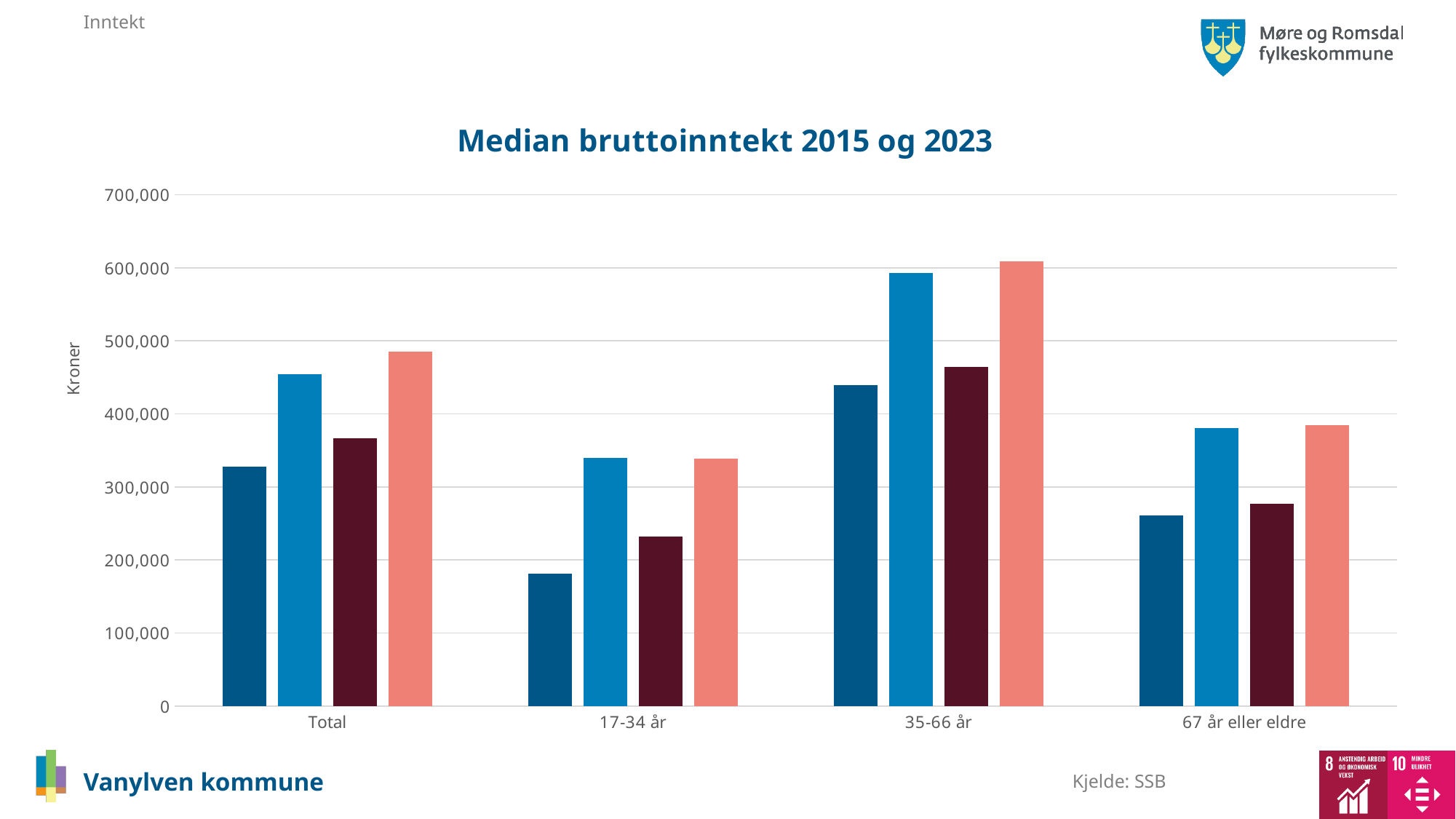
Is the value of the dark red (third) bar for 67 år eller eldre greater or less than 300,000? less What is the title of the chart? Median bruttoinntekt 2015 og 2023 Which is larger: the dark red (third) bar for Total or the dark red (third) bar for 35-66 år? 35-66 år Is the value of the dark blue (first) bar for Total greater or less than 300,000? greater Is the value of the light blue (second) bar for 35-66 år greater or less than 500,000? greater What is the label on the vertical axis of the chart? Kroner What kind of chart is shown on the slide? bar chart Which category contains the lowest bar in the chart? 17-34 år Which category has the tallest bars in the chart? 35-66 år How many categories are shown on the x axis of the chart? 4 How many bars are plotted for each category in the chart? 4